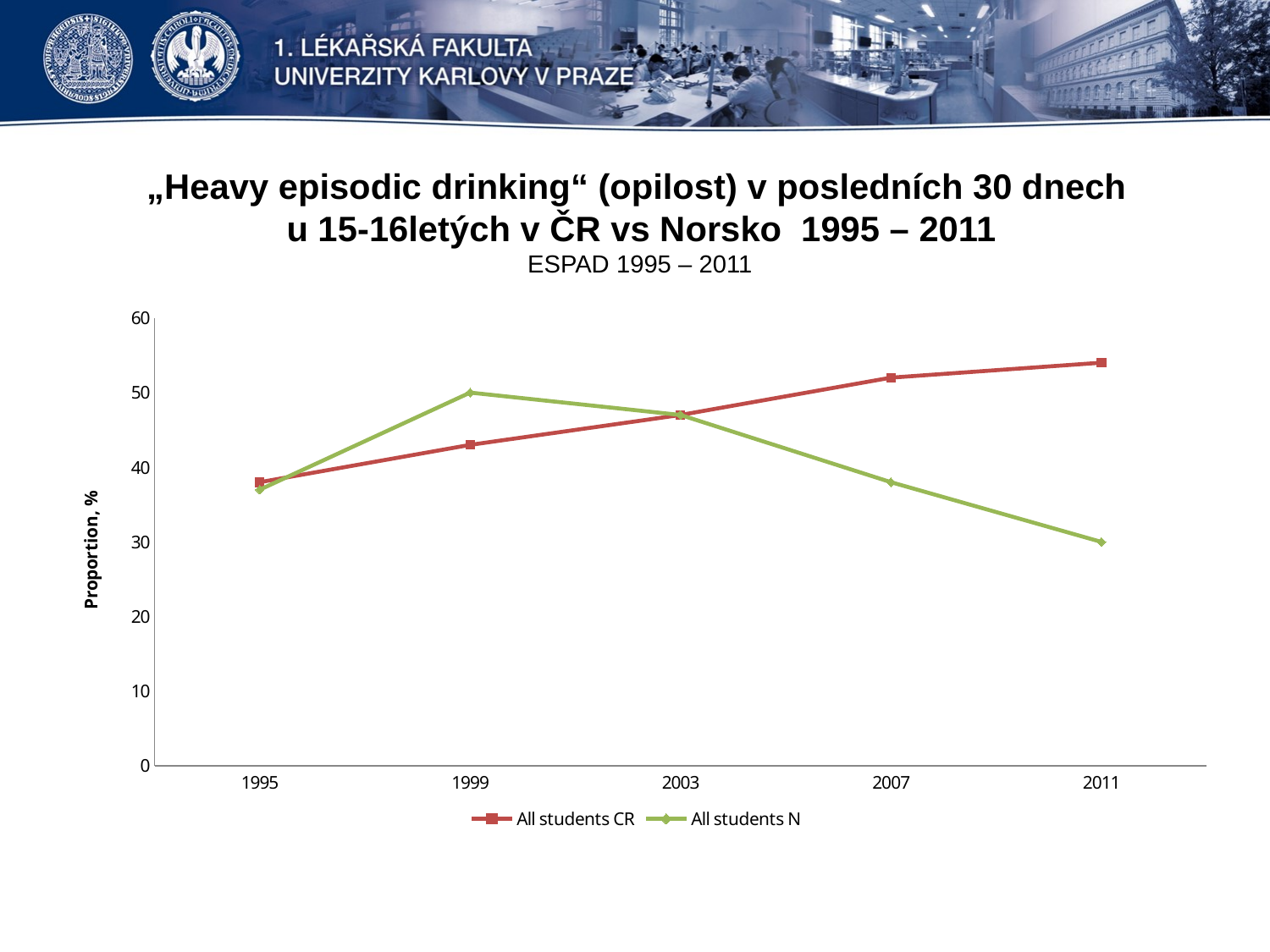
How many years are plotted along the x axis? 5 In which year does the All students N series reach its lowest value? 2011 Does the All students CR series rise or fall from 1995 to 2011? rise What kind of chart is shown on the slide? line chart In which year does the All students CR series reach its highest value? 2011 Is the value for All students CR in 1995 greater or less than 40? less Is the value for All students CR in 2011 greater or less than 50? greater In which year does the All students N series reach its highest value? 1999 In 1999, which series has the larger value, All students CR or All students N? All students N What is the label of the y axis? Proportion, % Is the value for All students N in 2007 greater or less than 40? less How many series does the legend list? 2